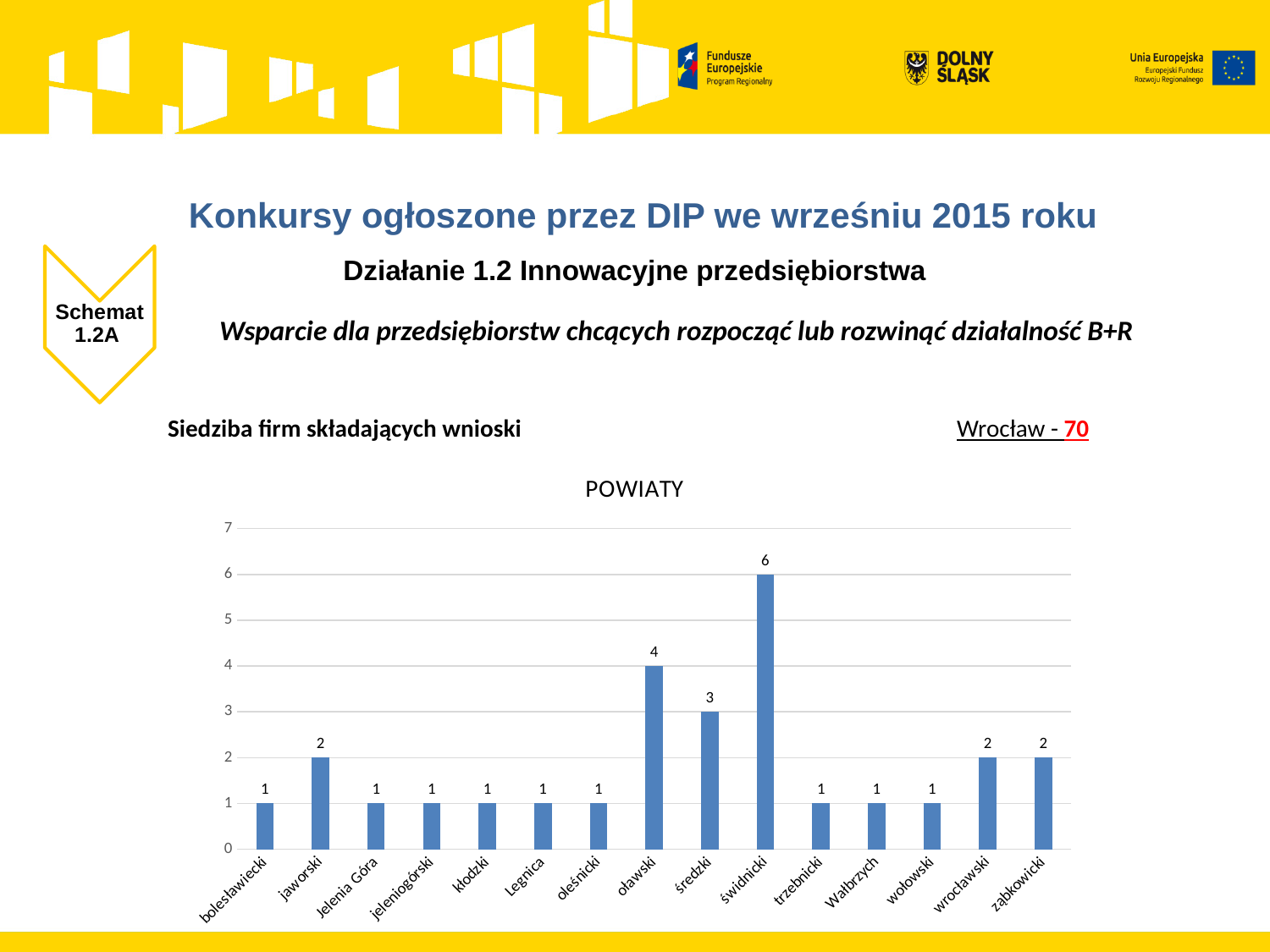
Which is larger, the value for średzki or the value for wrocławski? średzki What is the title of the chart? POWIATY What is the value for świdnicki? 6 What is the difference between the values for świdnicki and oławski? 2 Which category has the highest value in the chart? świdnicki What is the value for średzki? 3 What is the value for Wałbrzych? 1 How many categories (powiaty) are shown on the x axis of the chart? 15 What is the value for oławski? 4 What is the value for jaworski? 2 What kind of chart is shown on the slide? bar chart Is the value for oławski greater or less than 5? less